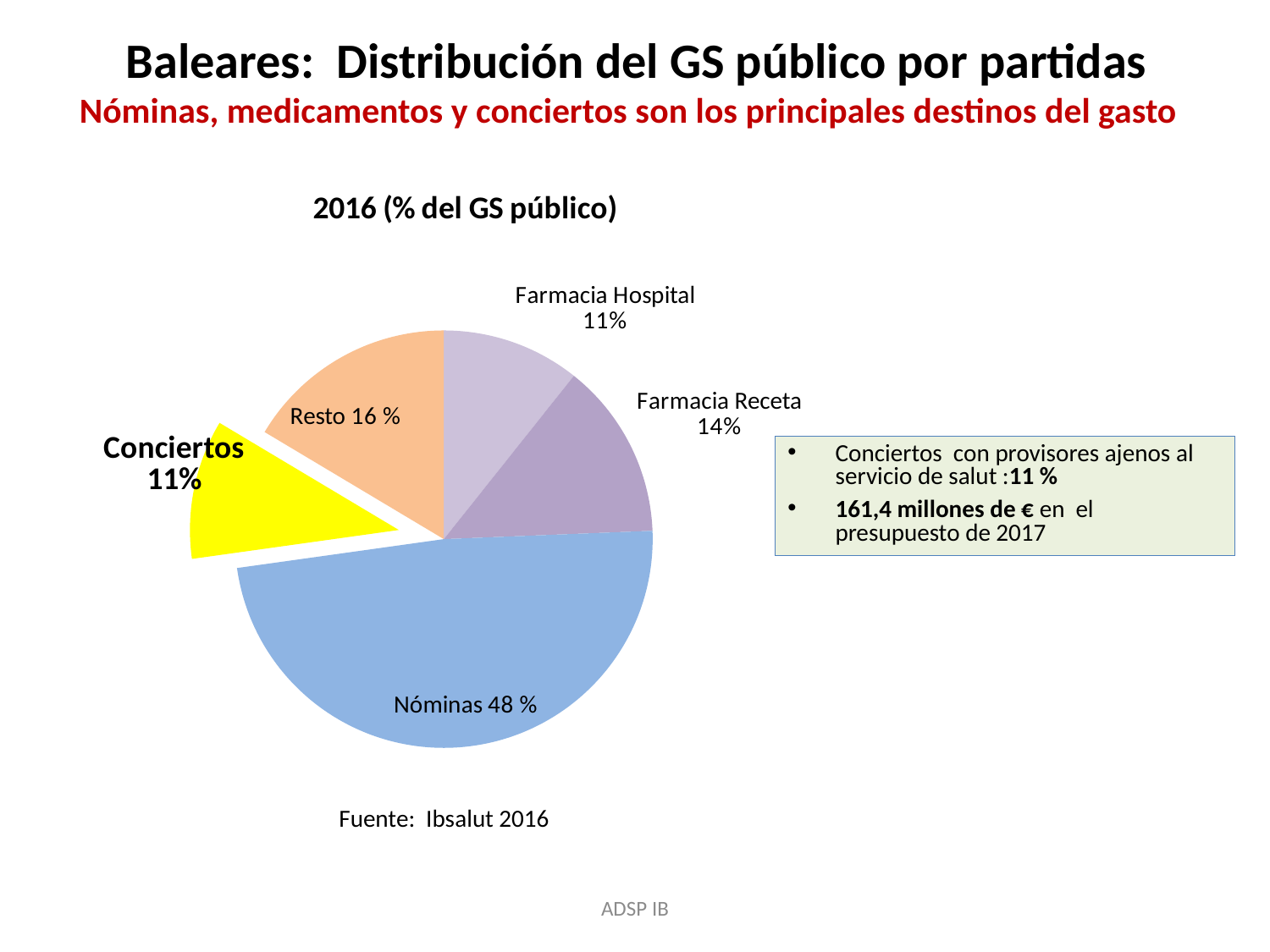
What is the title of the chart? 2016 (% del GS público) Which slice is pulled out (exploded) from the rest of the pie? Conciertos What kind of chart is shown on the slide? Pie chart What is the value shown for Farmacia Hospital? 11% What is the value shown for Resto? 16 % How many slices does the pie chart have? 5 What is the value shown for Farmacia Receta? 14% What is the value shown for Conciertos? 11% What percentage of the pie does Nóminas represent? 48 % Which category has the largest share of the pie? Nóminas What is the difference in percentage points between Nóminas and Farmacia Receta? 34 percentage points Which is larger, Farmacia Receta or Farmacia Hospital? Farmacia Receta